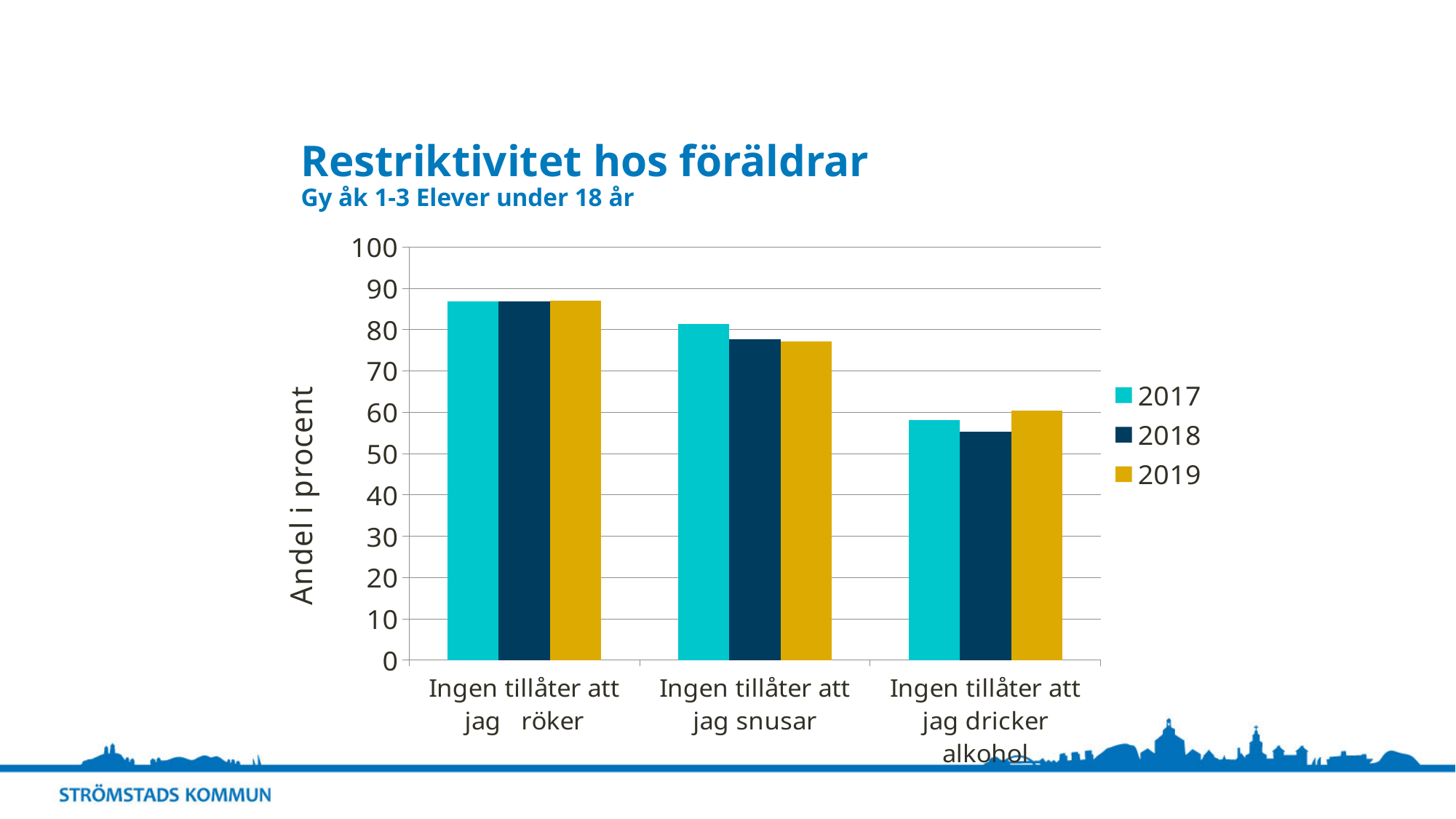
Is the 2017 value for 'Ingen tillåter att jag röker' greater or less than 80? greater How many series does the legend list? 3 Is the 2019 value for 'Ingen tillåter att jag snusar' greater or less than 70? greater Which category has the lowest value for 2018? Ingen tillåter att jag dricker alkohol For 'Ingen tillåter att jag snusar', which is larger: the 2017 value or the 2019 value? 2017 How many categories are shown on the x axis? 3 Is the 2018 value for 'Ingen tillåter att jag dricker alkohol' greater or less than 60? less For 'Ingen tillåter att jag dricker alkohol', which is larger: the 2018 value or the 2019 value? 2019 What kind of chart is shown on the slide? bar chart Do the 2017 values rise or fall from left to right across the categories? fall Which category has the highest value for 2017? Ingen tillåter att jag röker